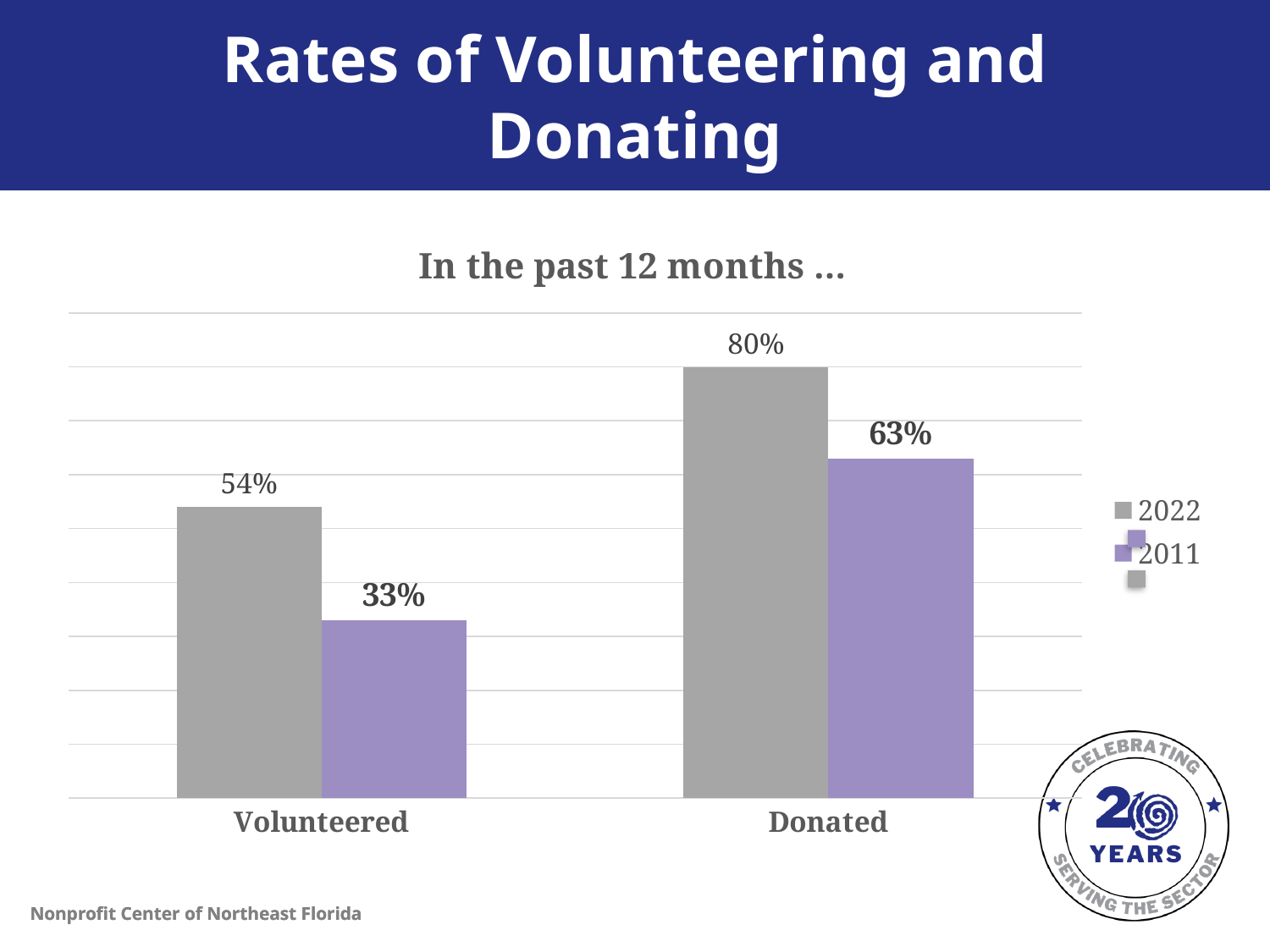
Which category has the highest value in the 2022 series? Donated What is the value for Donated in 2022? 80% What kind of chart is shown on the slide? Bar chart What is the difference between the 2022 and 2011 values for Volunteered? 21% What is the difference between the 2022 and 2011 values for Donated? 17% How many series does the legend list? 2 What is the value for Donated in 2011? 63% What is the value for Volunteered in 2011? 33% Which category has the lowest value in the 2011 series? Volunteered How many categories are shown on the x axis? 2 Which is larger, the 2022 value for Volunteered or the 2011 value for Donated? 2011 value for Donated What is the value for Volunteered in 2022? 54%